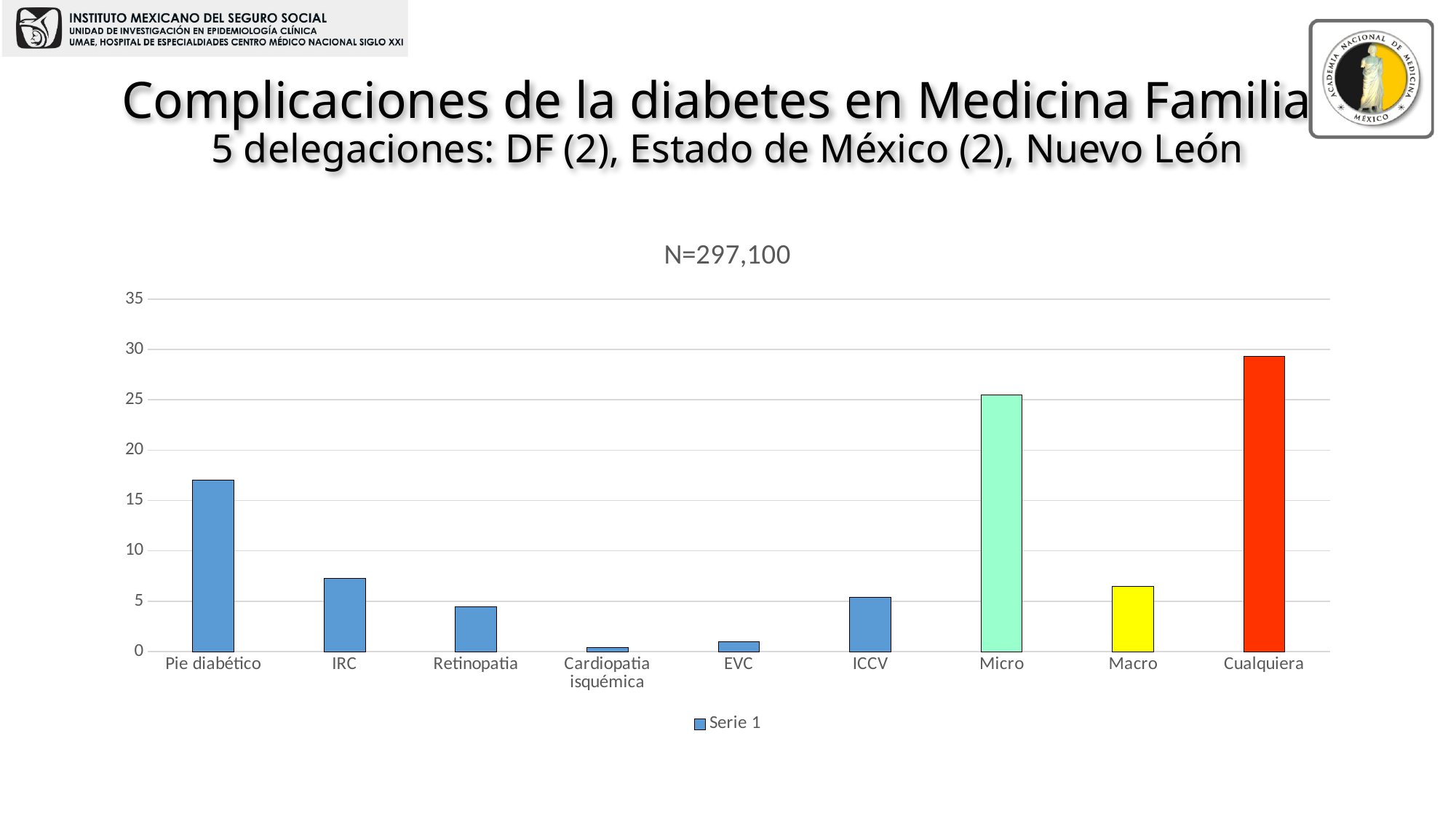
Is the value for Pie diabético greater or less than 15? greater Is the value for Cualquiera greater or less than 25? greater What is the title shown above the chart? N=297,100 Which is larger, the value for Pie diabético or the value for IRC? Pie diabético How many categories are shown on the x axis? 9 Which category has the highest bar? Cualquiera How many series does the legend list? 1 Which is larger, the value for Micro or the value for Macro? Micro Is the value for Micro greater or less than 30? less Which category has the lowest bar? Cardiopatia isquémica What kind of chart is shown on the slide? bar chart